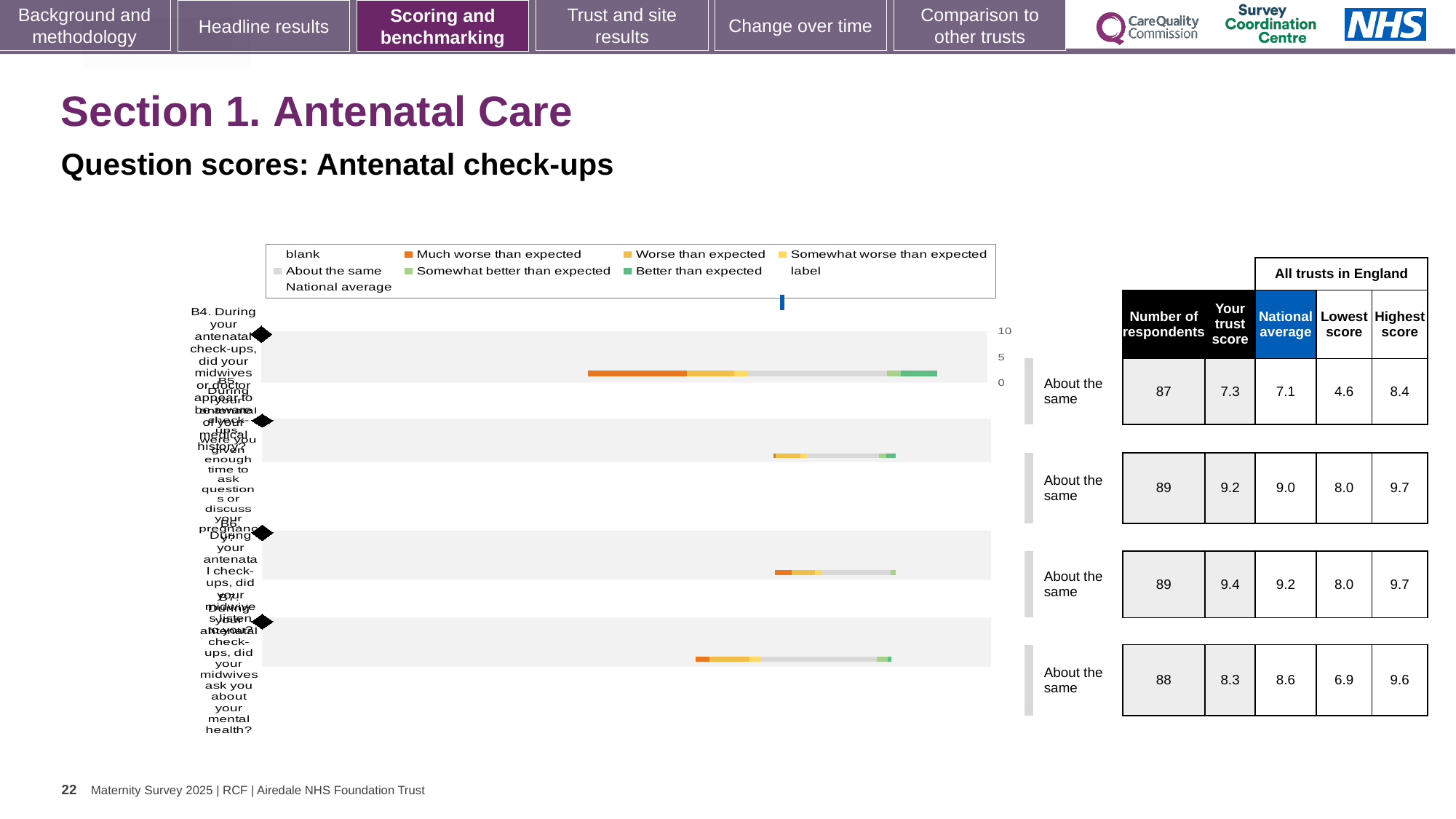
What colour does the legend use for 'Much worse than expected'? orange How many questions (B4 to B7) are plotted as bars in the chart? 4 What is the difference between the trust score and the national average for question B4? 0.2 Which question has the highest 'Your trust score' in the table beside the chart? B6 In the table beside the chart, what is the 'Your trust score' for question B4? 7.3 Which question has the lowest 'Your trust score' in the table beside the chart? B4 In the table beside the chart, what is the highest score for question B7? 9.6 What colour does the legend use for 'Better than expected'? green What kind of chart is shown on the slide? bar chart In the table beside the chart, how many respondents answered question B6? 89 For question B7, which is larger: the trust score or the national average? national average In the table beside the chart, what is the national average for question B5? 9.0